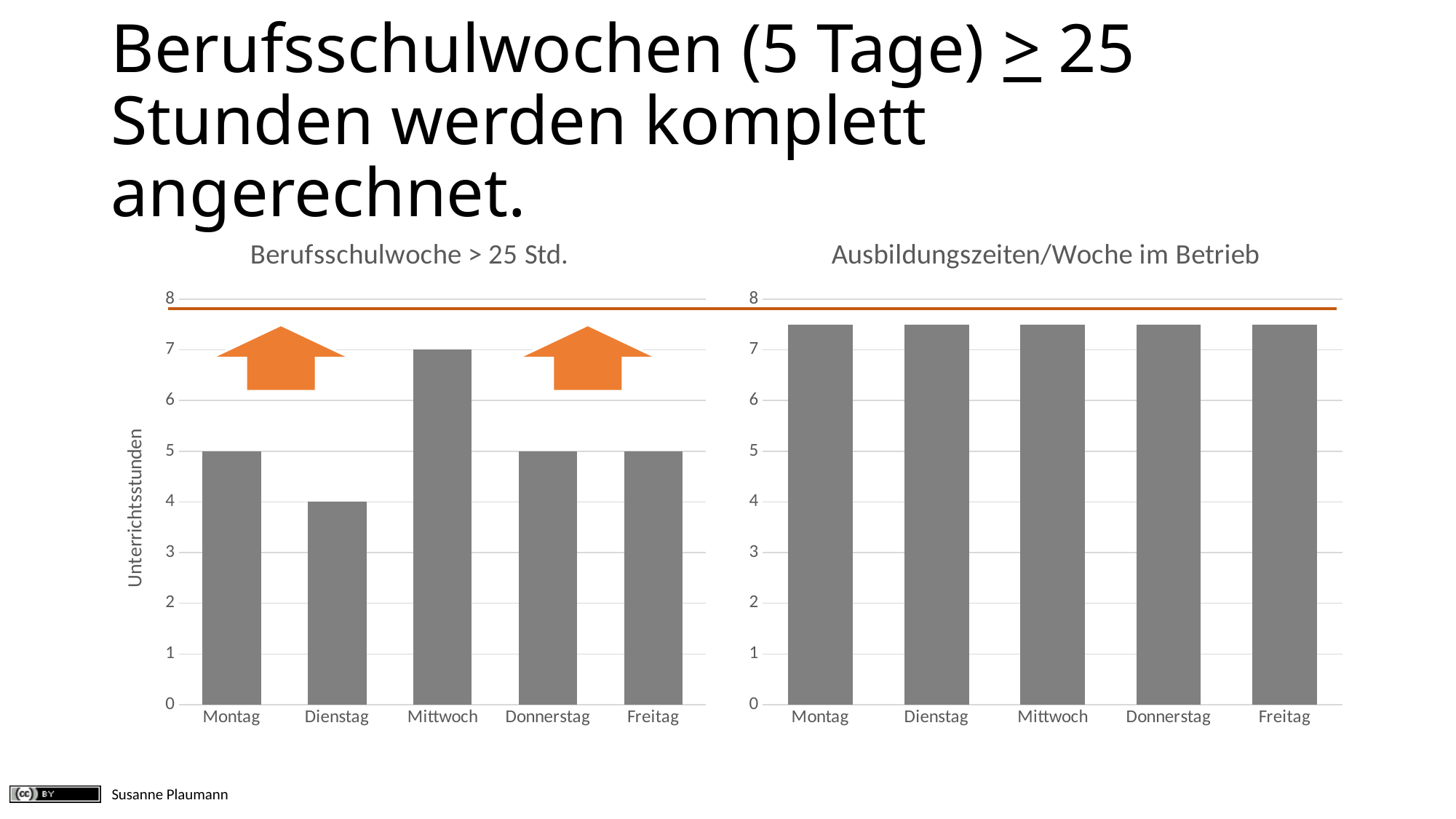
In the chart titled "Berufsschulwoche > 25 Std.", which day has the highest value? Mittwoch What is the y-axis label of the chart titled "Berufsschulwoche > 25 Std."? Unterrichtsstunden What kind of chart is the chart titled "Berufsschulwoche > 25 Std."? bar chart In the chart titled "Ausbildungszeiten/Woche im Betrieb", is the value for Freitag greater or less than 8? less In the chart titled "Berufsschulwoche > 25 Std.", what is the value for Montag? 5 In the chart titled "Berufsschulwoche > 25 Std.", what is the difference between the values for Mittwoch and Dienstag? 3 In the chart titled "Ausbildungszeiten/Woche im Betrieb", is the value for Montag greater or less than 7? greater In the chart titled "Berufsschulwoche > 25 Std.", what is the value for Mittwoch? 7 How many categories are shown on the x axis of the chart titled "Ausbildungszeiten/Woche im Betrieb"? 5 In the chart titled "Berufsschulwoche > 25 Std.", what is the value for Dienstag? 4 In the chart titled "Berufsschulwoche > 25 Std.", which day has the lowest value? Dienstag In the chart titled "Berufsschulwoche > 25 Std.", which is larger, the value for Mittwoch or the value for Freitag? Mittwoch